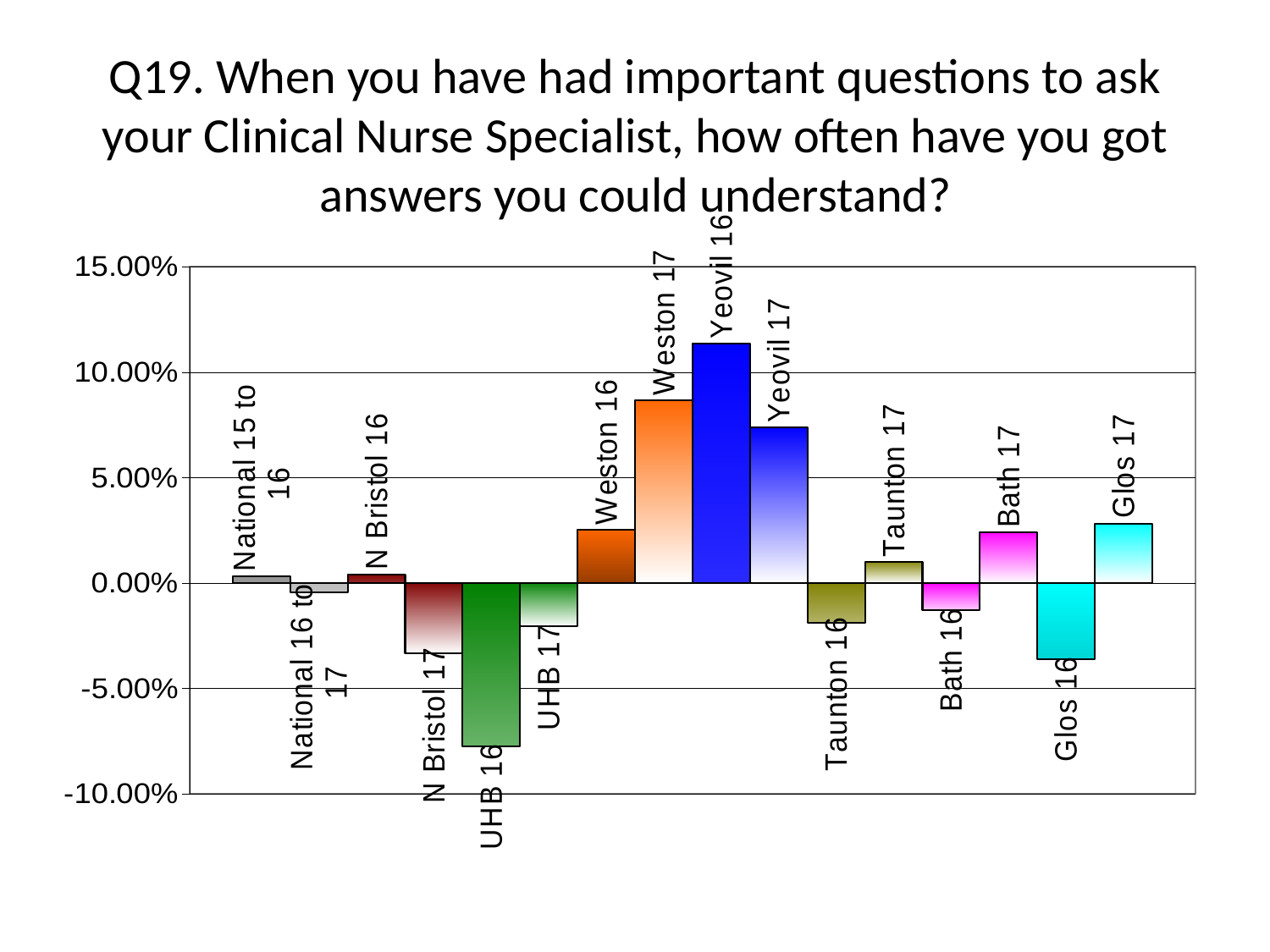
Is the value for Yeovil 16 greater or less than 10.00%? greater Is the value for Weston 17 greater or less than 5.00%? greater Which category has the lowest value in the chart? UHB 16 Which is larger, the value for Weston 17 or the value for Yeovil 17? Weston 17 How many bars (categories) are plotted in the chart? 16 What type of chart is shown on the slide? bar chart What question number is referenced in the chart title? Q19 Is the value for UHB 16 greater or less than -5.00%? less Which category has the highest value in the chart? Yeovil 16 Which is lower, the value for N Bristol 17 or the value for UHB 16? UHB 16 Which is larger, the value for Weston 16 or the value for Weston 17? Weston 17